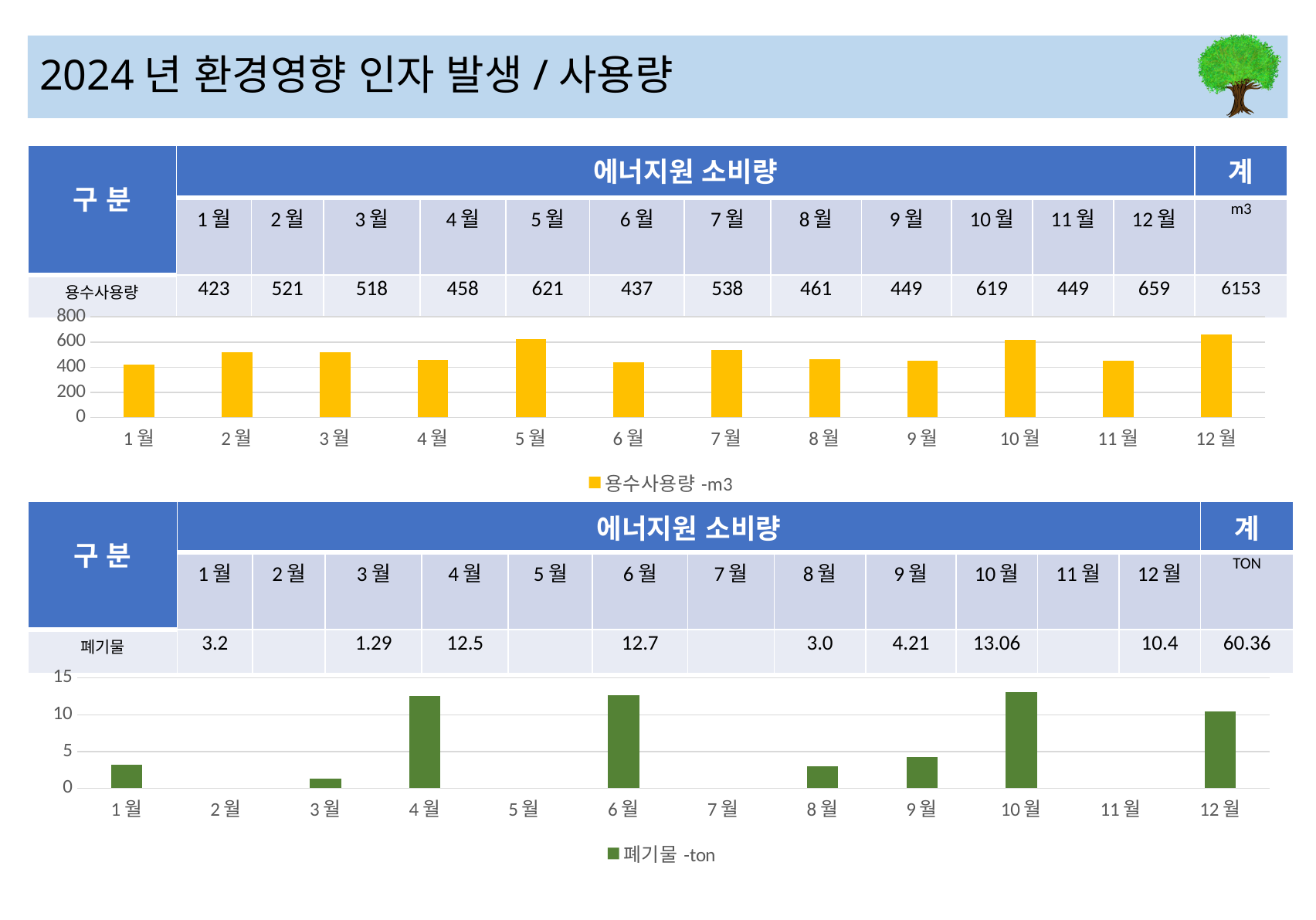
What kind of chart is the top chart (용수사용량 -m3)? bar chart In the top chart (용수사용량 -m3), how many months are plotted on the x axis? 12 In the bottom chart (폐기물 -ton), what is the value for 10 월? 13.06 In the bottom chart (폐기물 -ton), is the value for 6 월 greater or less than 10? greater In the top chart (용수사용량 -m3), what is the difference between the values for 12 월 and 1 월? 236 In the bottom chart (폐기물 -ton), which is larger, the value for 4 월 or the value for 12 월? 4 월 In the bottom chart (폐기물 -ton), which month has the highest value? 10 월 In the top chart (용수사용량 -m3), which month has the lowest value? 1 월 In the top chart (용수사용량 -m3), what is the value for 5 월? 621 In the top chart (용수사용량 -m3), is the value for 10 월 greater or less than 600? greater In the top chart (용수사용량 -m3), which month has the highest value? 12 월 What is the legend entry of the bottom chart? 폐기물 -ton